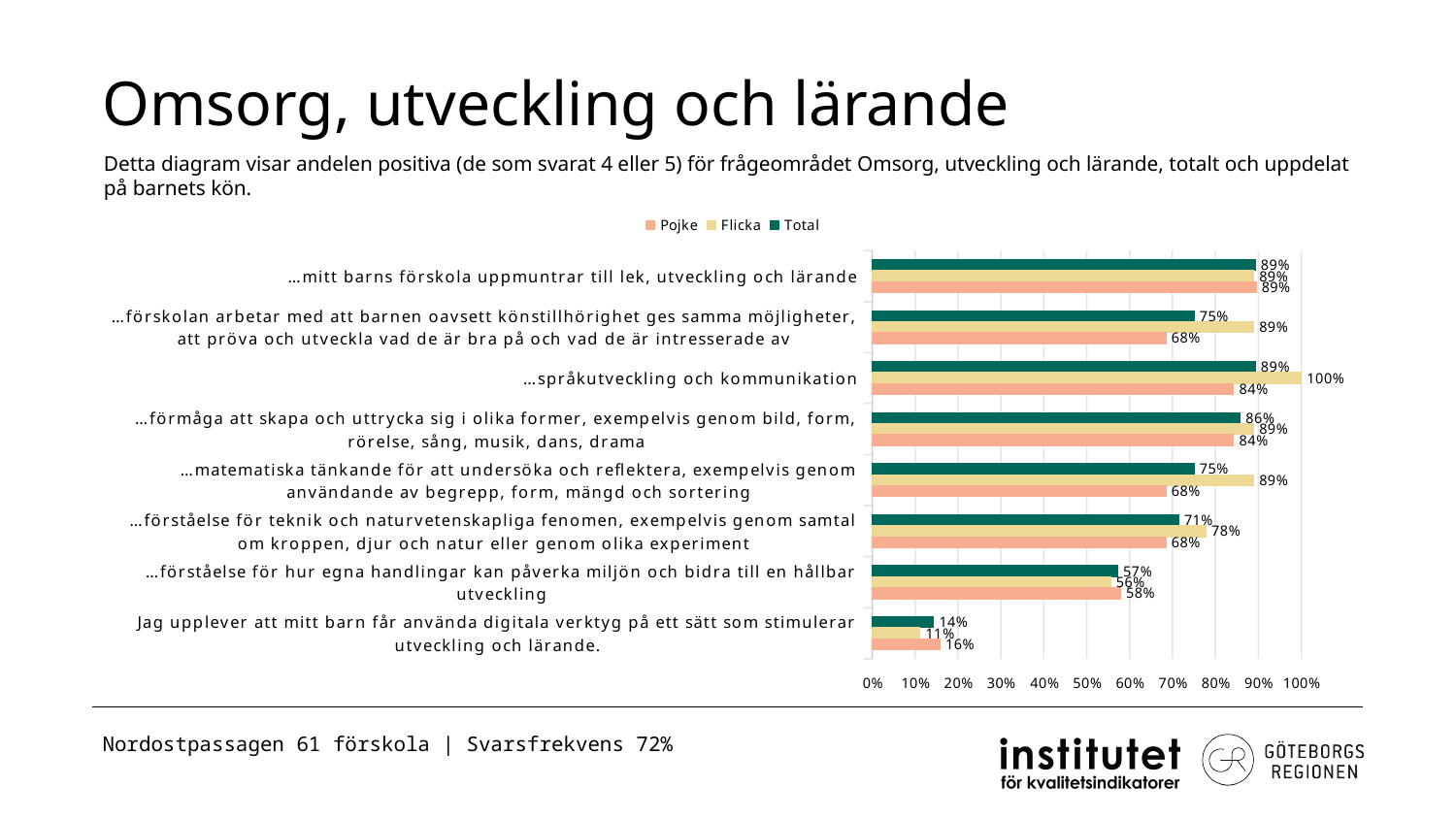
What kind of chart is shown on the slide? Bar chart How many categories are shown on the chart? 8 What is the Pojke value for "…förståelse för teknik och naturvetenskapliga fenomen…"? 68% What is the Total value for "…förmåga att skapa och uttrycka sig i olika former…"? 86% Which category has the highest Flicka value? …språkutveckling och kommunikation What is the difference between the Flicka and Pojke values for "…matematiska tänkande för att undersöka och reflektera…"? 21 percentage points How many series does the legend list? 3 For "…förståelse för hur egna handlingar kan påverka miljön och bidra till en hållbar utveckling", which is larger, the Pojke value or the Flicka value? Pojke Which category has the lowest Total value? Jag upplever att mitt barn får använda digitala verktyg på ett sätt som stimulerar utveckling och lärande. What is the Flicka value for "…språkutveckling och kommunikation"? 100% Which series is shown in green on the chart? Total What is the Total value for "Jag upplever att mitt barn får använda digitala verktyg på ett sätt som stimulerar utveckling och lärande."? 14%